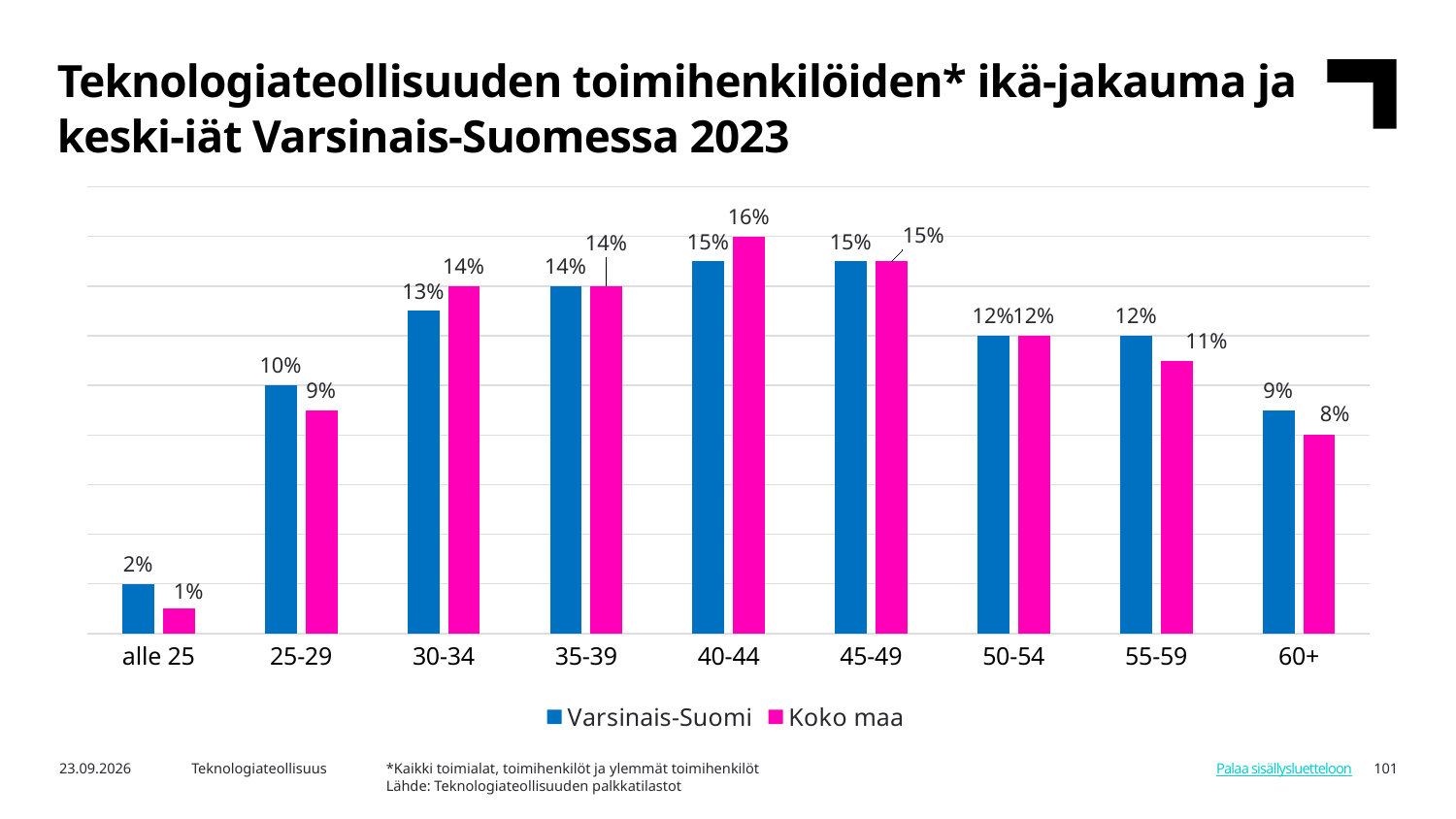
Which age group has the highest value for Koko maa? 40-44 Do the Koko maa values rise or fall from the 45-49 age group to the 60+ age group? fall What is the value for Koko maa in the 40-44 age group? 16% How many series does the legend list? 2 Which series is shown in pink in the legend? Koko maa In the 25-29 age group, which series has the larger value, Varsinais-Suomi or Koko maa? Varsinais-Suomi What type of chart is shown on the slide? bar chart How many age categories are shown on the x axis? 9 What is the value for Varsinais-Suomi in the 60+ age group? 9% What is the difference between Varsinais-Suomi and Koko maa in the 55-59 age group? 1% Which age group has the lowest value for Varsinais-Suomi? alle 25 What is the value for Varsinais-Suomi in the 30-34 age group? 13%